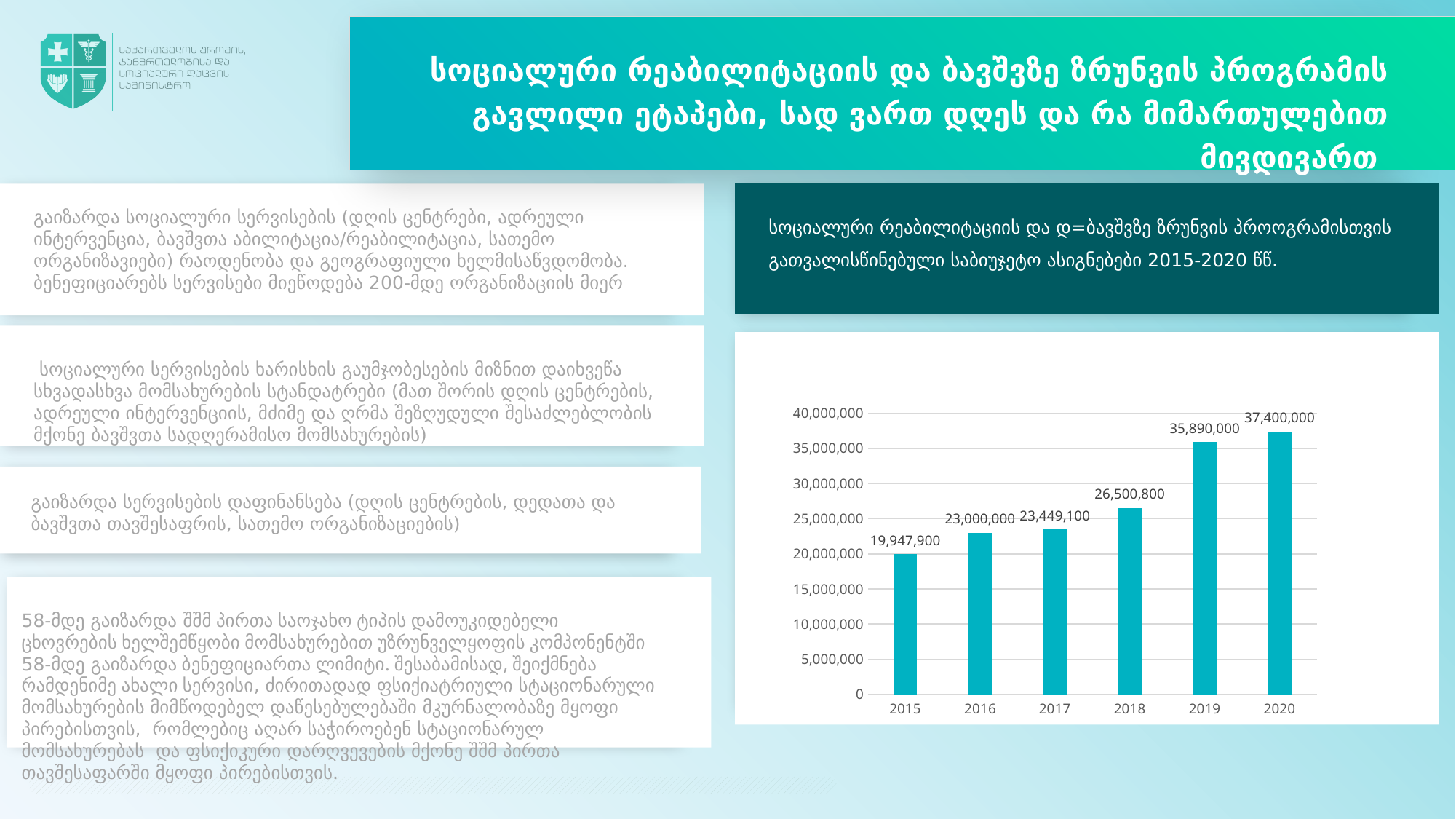
Which is larger, the value for 2019 or the value for 2018? 2019 Which year has the lowest value? 2015 What kind of chart is shown? bar chart Is the value for 2016 greater or less than 25,000,000? less Which year has the highest value? 2020 What is the difference between the values for 2020 and 2019? 1,510,000 What is the difference between the values for 2019 and 2018? 9,389,200 What is the value for 2020? 37,400,000 What is the value for 2018? 26,500,800 What is the value for 2015? 19,947,900 What is the value for 2017? 23,449,100 How many years are shown on the x axis? 6